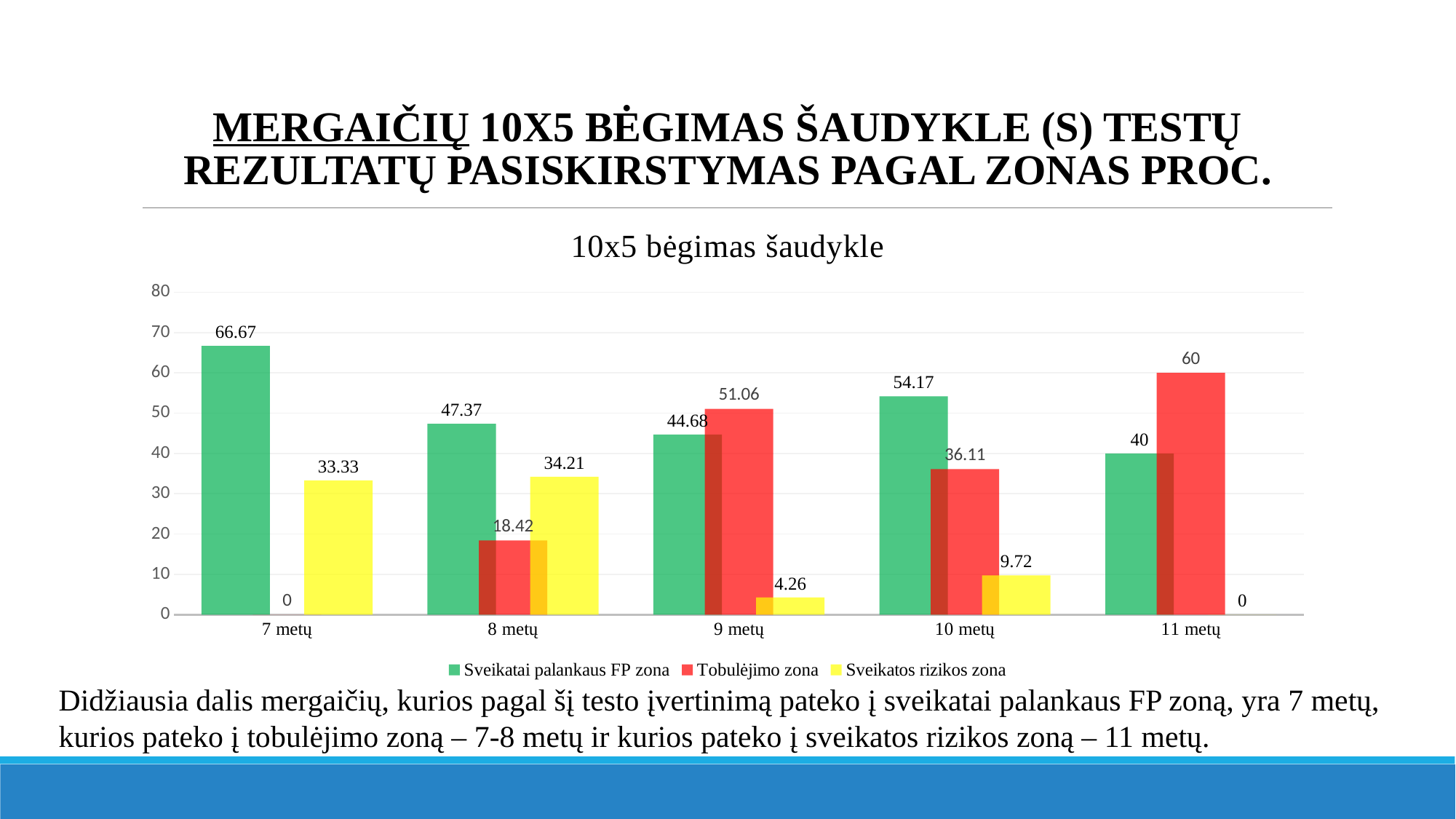
Which age group has the lowest value for Sveikatai palankaus FP zona? 11 metų What is the value for Sveikatos rizikos zona at 10 metų? 9.72 At 10 metų, which is larger: Sveikatai palankaus FP zona or Tobulėjimo zona? Sveikatai palankaus FP zona What is the value for Sveikatai palankaus FP zona at 7 metų? 66.67 Which age group has the highest value for Sveikatai palankaus FP zona? 7 metų What is the title of the chart? 10x5 bėgimas šaudykle What is the difference between the Sveikatos rizikos zona values at 8 metų and 9 metų? 29.95 How many age groups are shown on the x axis? 5 What is the value for Tobulėjimo zona at 9 metų? 51.06 What kind of chart is shown? Bar chart How many series does the legend list? 3 What is the value for Tobulėjimo zona at 11 metų? 60